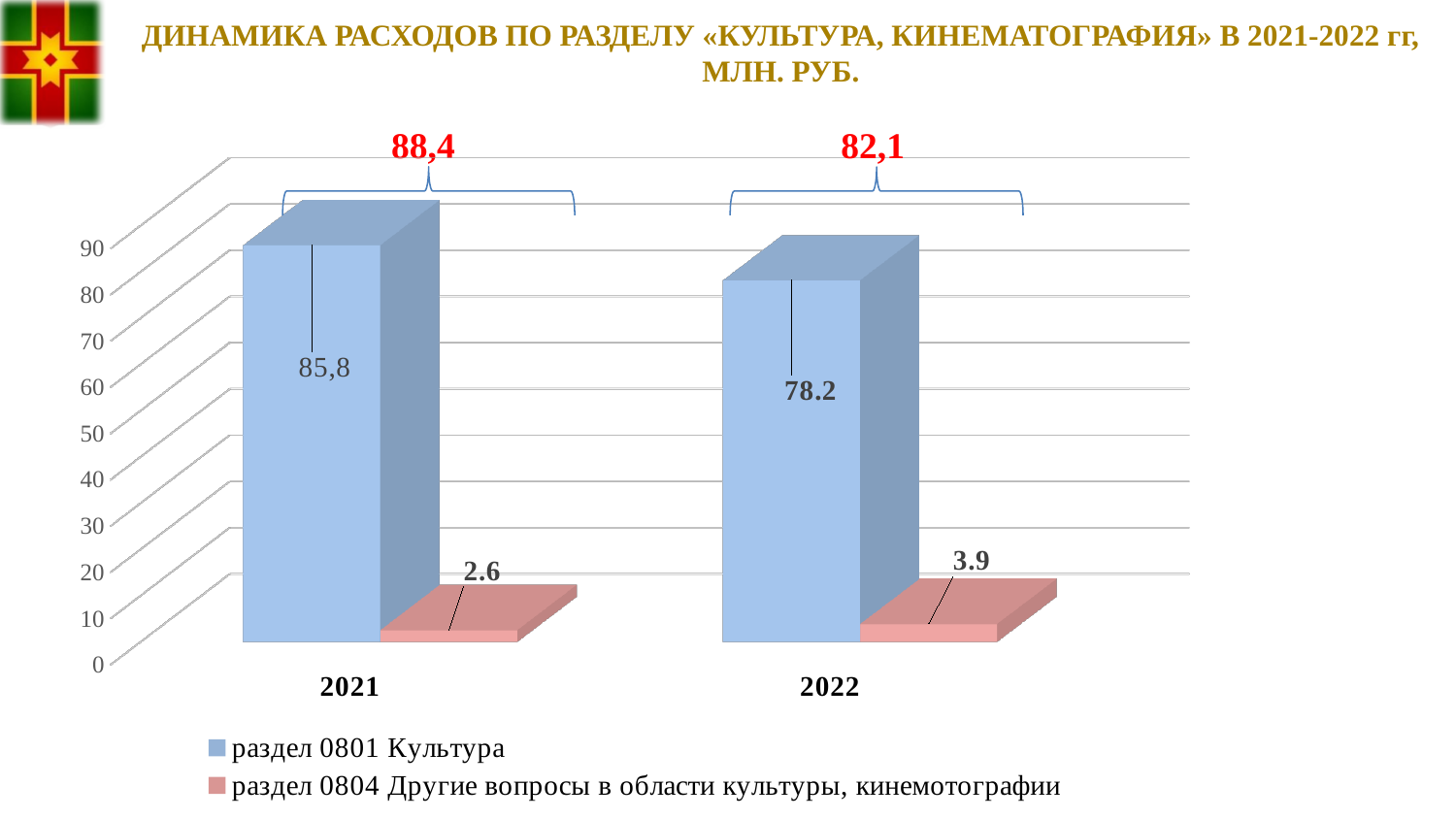
How many series does the legend list? 2 By how much did the value for раздел 0801 Культура decrease from 2021 to 2022? 7.6 What is the total expenditure shown above the bars for 2021? 88,4 Which is larger: раздел 0804 in 2022 or раздел 0804 in 2021? раздел 0804 in 2022 What kind of chart is shown on the slide? bar chart What is the value for раздел 0804 Другие вопросы в области культуры, кинемотографии in 2022? 3.9 What is the value for раздел 0801 Культура in 2022? 78.2 What is the value for раздел 0801 Культура in 2021? 85,8 What is the value for раздел 0804 Другие вопросы в области культуры, кинемотографии in 2021? 2.6 In which year is the value for раздел 0801 Культура higher? 2021 What is the total expenditure shown above the bars for 2022? 82,1 In which year is the value for раздел 0804 Другие вопросы в области культуры, кинемотографии lower? 2021